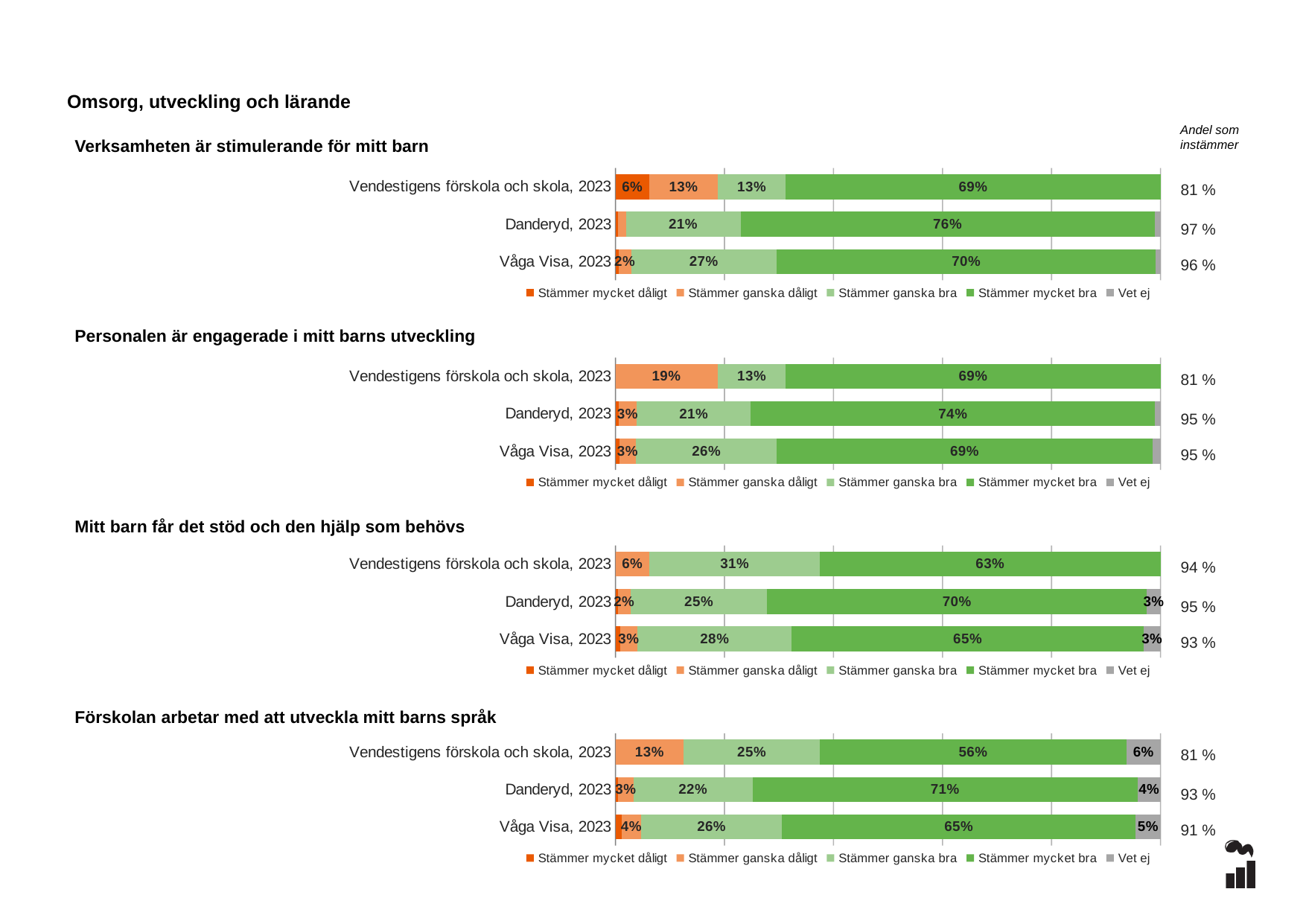
In the chart 'Personalen är engagerade i mitt barns utveckling', what is the 'Stämmer ganska dåligt' value for Vendestigens förskola och skola, 2023? 19% In the chart 'Mitt barn får det stöd och den hjälp som behövs', what is the 'Stämmer ganska bra' value for Vendestigens förskola och skola, 2023? 31% In the chart 'Förskolan arbetar med att utveckla mitt barns språk', what is the 'Vet ej' value for Vendestigens förskola och skola, 2023? 6% What kind of chart is 'Mitt barn får det stöd och den hjälp som behövs'? Stacked bar chart In the chart 'Förskolan arbetar med att utveckla mitt barns språk', which row has the lowest 'Stämmer mycket bra' value? Vendestigens förskola och skola, 2023 In the chart 'Mitt barn får det stöd och den hjälp som behövs', what is the difference between the 'Stämmer mycket bra' values for Danderyd, 2023 and Vendestigens förskola och skola, 2023? 7% In the chart 'Verksamheten är stimulerande för mitt barn', what is the 'Stämmer ganska dåligt' value for Vendestigens förskola och skola, 2023? 13% How many rows (categories) are shown in the chart 'Förskolan arbetar med att utveckla mitt barns språk'? 3 In the chart 'Verksamheten är stimulerande för mitt barn', what is the 'Stämmer mycket bra' value for Danderyd, 2023? 76% In the chart 'Verksamheten är stimulerande för mitt barn', which row has the highest 'Stämmer mycket bra' value? Danderyd, 2023 In the chart 'Personalen är engagerade i mitt barns utveckling', which is larger: the 'Stämmer ganska bra' value for Våga Visa, 2023 or for Danderyd, 2023? Våga Visa, 2023 How many series does the legend list in the chart 'Verksamheten är stimulerande för mitt barn'? 5